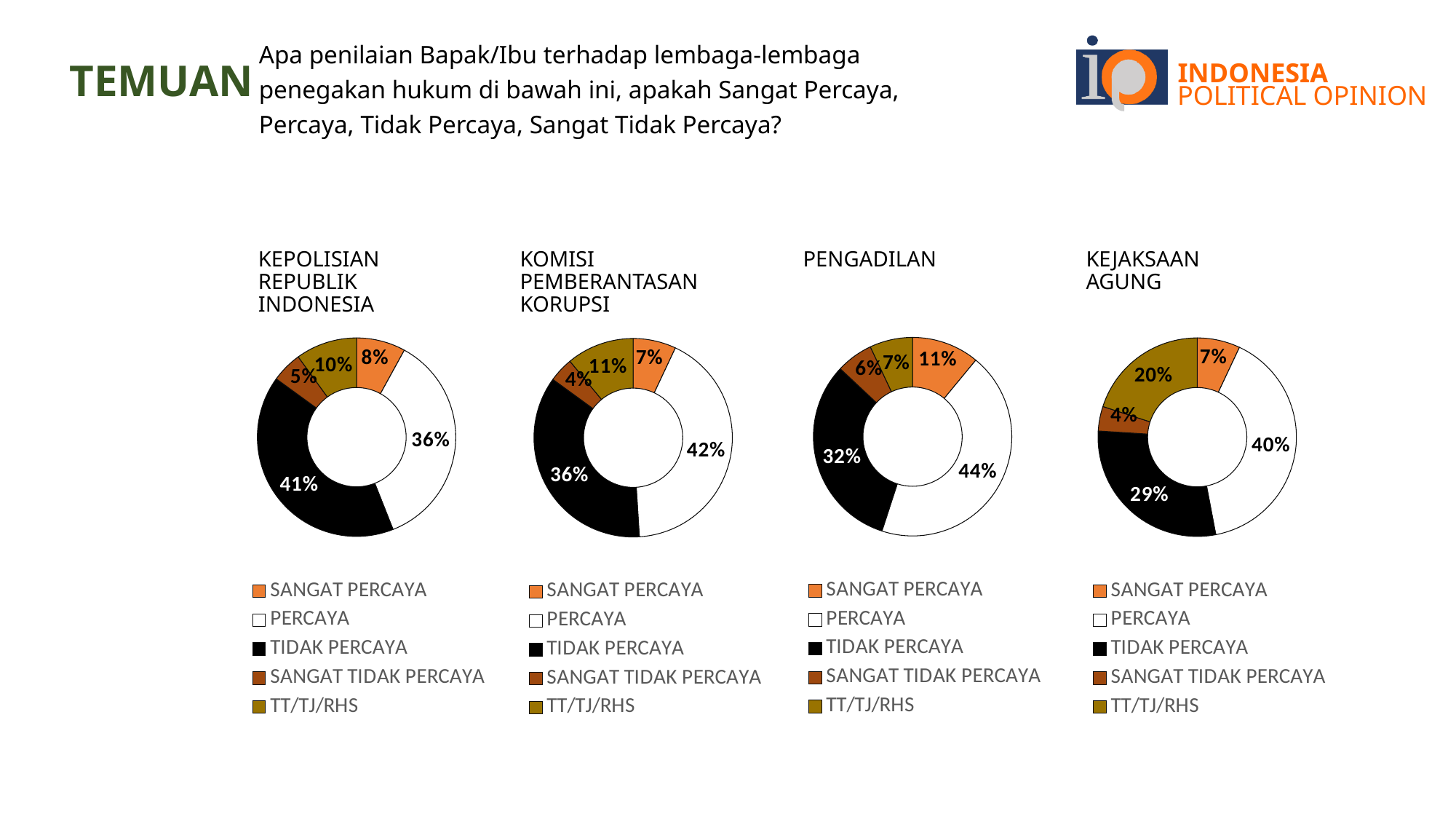
In the KEJAKSAAN AGUNG chart, what percentage is shown for TT/TJ/RHS? 20% How many categories does the legend of the PENGADILAN chart list? 5 In the KEPOLISIAN REPUBLIK INDONESIA chart, which category has the largest share? TIDAK PERCAYA In the KEJAKSAAN AGUNG chart, what is the difference between PERCAYA and TIDAK PERCAYA? 11% In the PENGADILAN chart, which category has the smallest share? SANGAT TIDAK PERCAYA In the PENGADILAN chart, what percentage is shown for SANGAT PERCAYA? 11% In the KOMISI PEMBERANTASAN KORUPSI chart, what percentage is shown for PERCAYA? 42% How many charts are shown on the slide? 4 In the KEPOLISIAN REPUBLIK INDONESIA chart, what percentage is shown for TIDAK PERCAYA? 41% What kind of chart is used for KEJAKSAAN AGUNG? Doughnut chart In the KOMISI PEMBERANTASAN KORUPSI chart, what is the combined share of SANGAT PERCAYA and PERCAYA? 49% In the KOMISI PEMBERANTASAN KORUPSI chart, which is larger, PERCAYA or TIDAK PERCAYA? PERCAYA